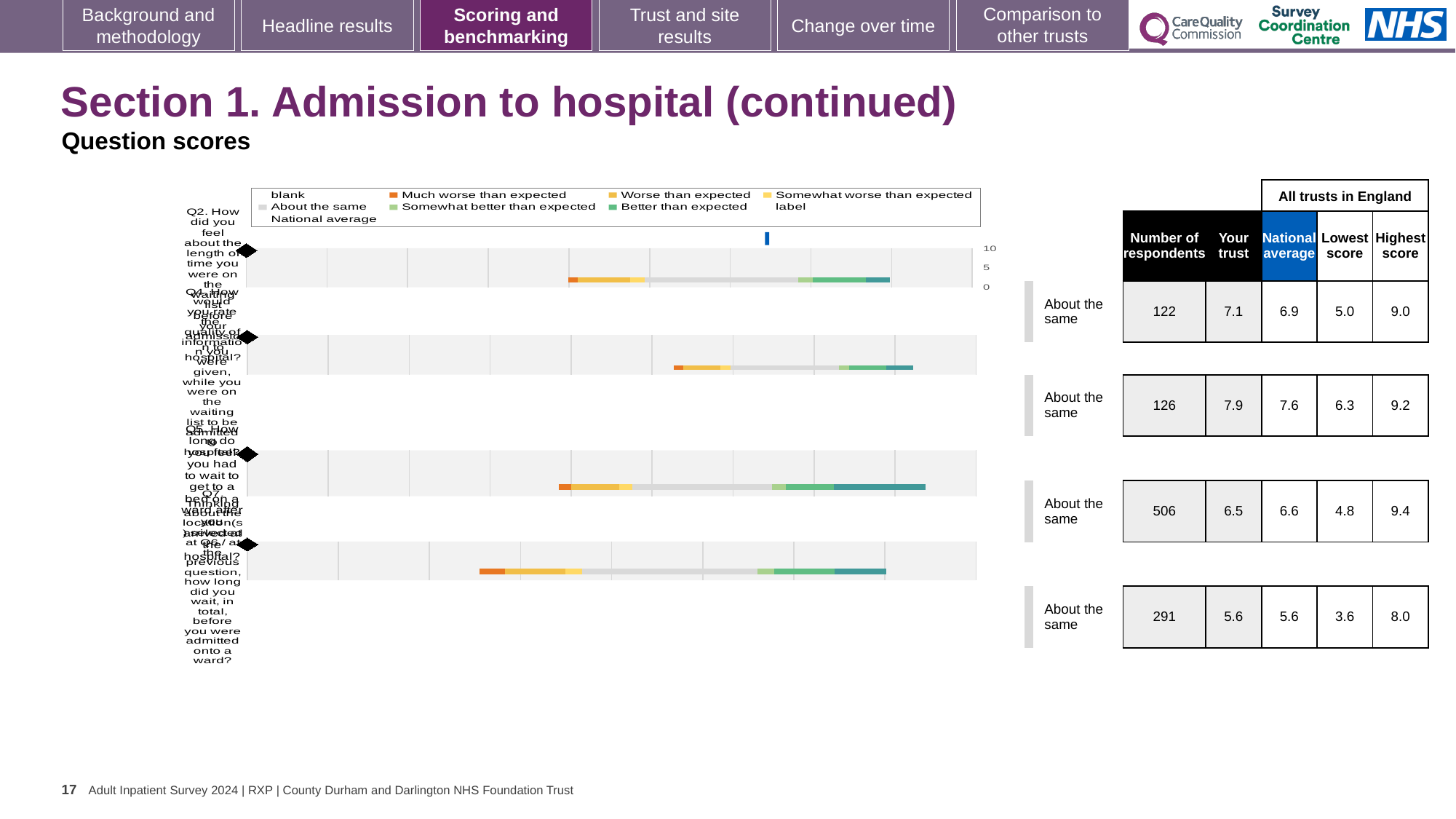
Which row in the table beside the chart has the highest number of respondents? the third row (506) What kind of chart is shown on the slide? bar chart What colour represents 'Much worse than expected' in the chart legend? orange In the table beside the chart, what is the 'Your trust' score for the second row? 7.9 In the fourth (bottom) row of the table, what is the difference between the highest score and the lowest score? 4.4 In the table beside the chart, what is the number of respondents for the first (top) row? 122 What is the highest tick value shown on the chart's axis? 10 How many entries does the chart legend list? 9 How many question bars are plotted in the chart? 4 What benchmark label is shown next to each of the four bars? About the same Which row in the table beside the chart has the lowest 'Your trust' score? the fourth row (5.6) In the third row of the table, which is larger: the 'Your trust' score or the 'National average'? National average